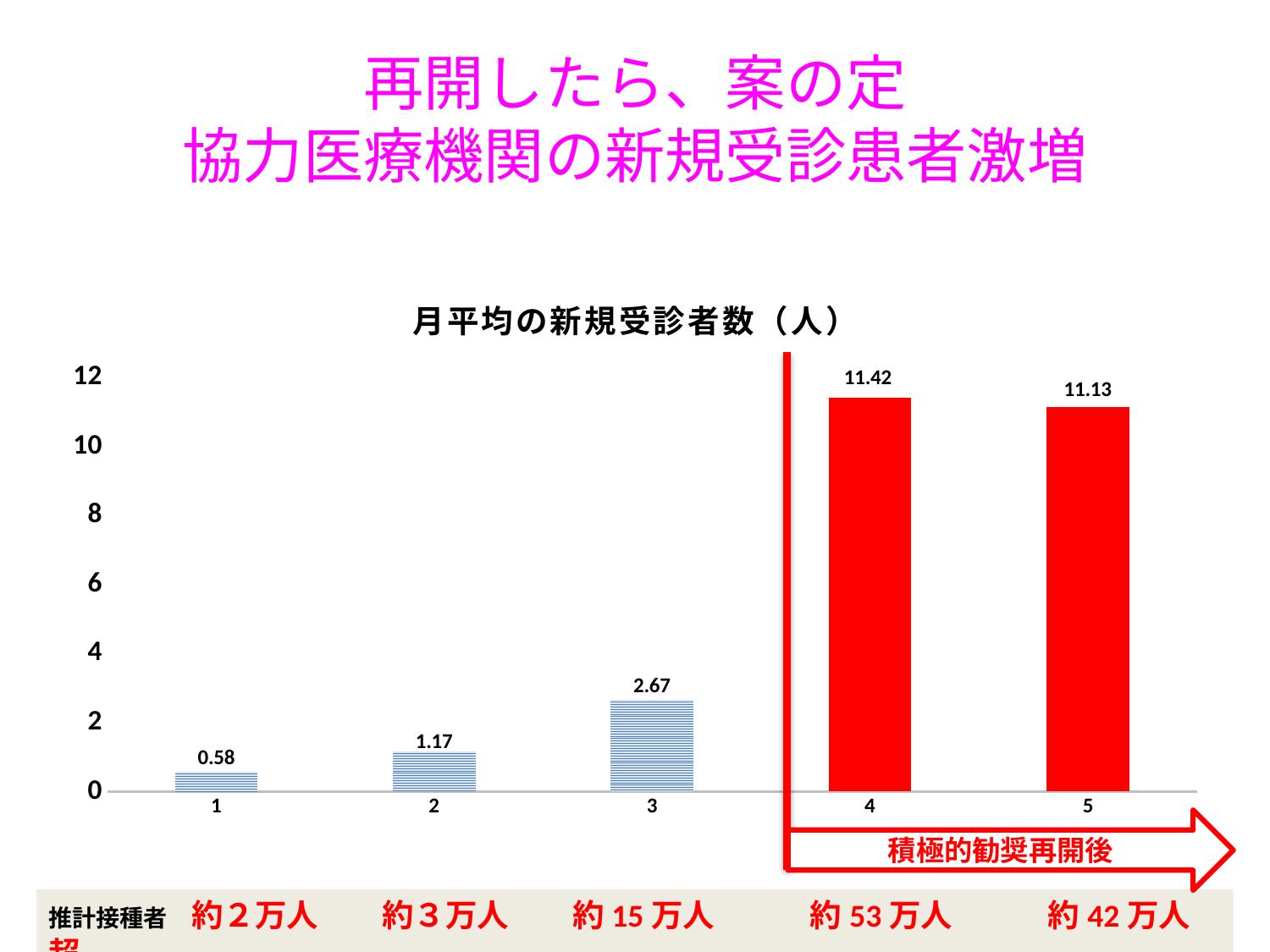
What is the value for category 5? 11.13 What kind of chart is shown? bar chart What is the value for category 1? 0.58 Which is larger, the value for category 2 or category 3? 3 What is the title of the chart? 月平均の新規受診者数（人） What is the difference between the values for category 4 and category 3? 8.75 What is the value for category 4? 11.42 How many categories are shown on the x axis? 5 What is the value for category 3? 2.67 Which category has the highest value? 4 Which category has the lowest value? 1 Is the value for category 5 greater or less than 10? greater